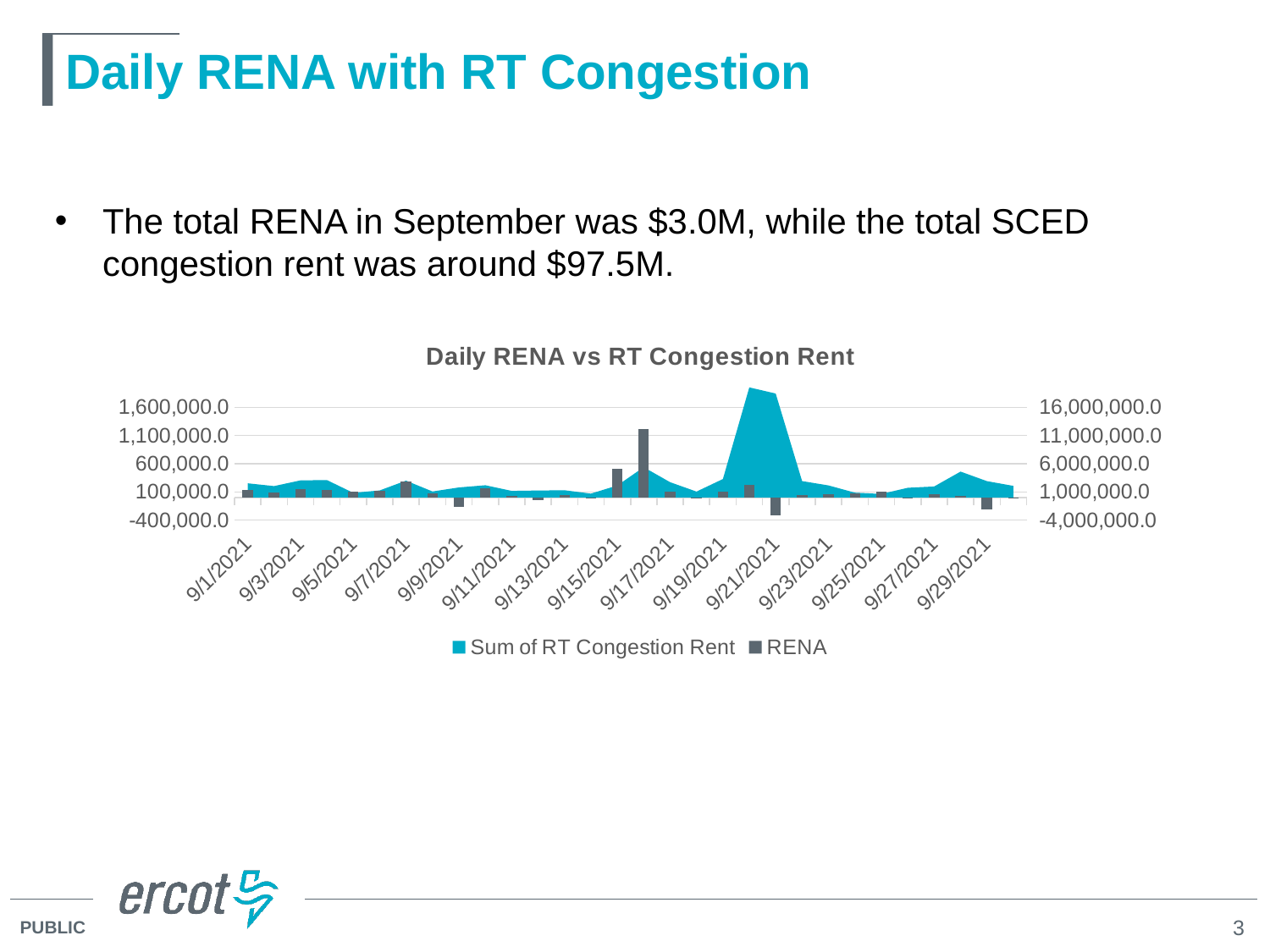
Which series in the chart is drawn as bars? RENA How many series does the chart's legend list? 2 Is the Sum of RT Congestion Rent value for 9/1/2021 greater or less than 6,000,000.0? less Is the RENA value for 9/21/2021 greater or less than 0? less Is the Sum of RT Congestion Rent value for 9/21/2021 greater or less than 11,000,000.0? greater Which date has the larger Sum of RT Congestion Rent value, 9/17/2021 or 9/21/2021? 9/21/2021 What is the title of the chart on the slide? Daily RENA vs RT Congestion Rent How many date labels are shown along the x axis of the chart? 15